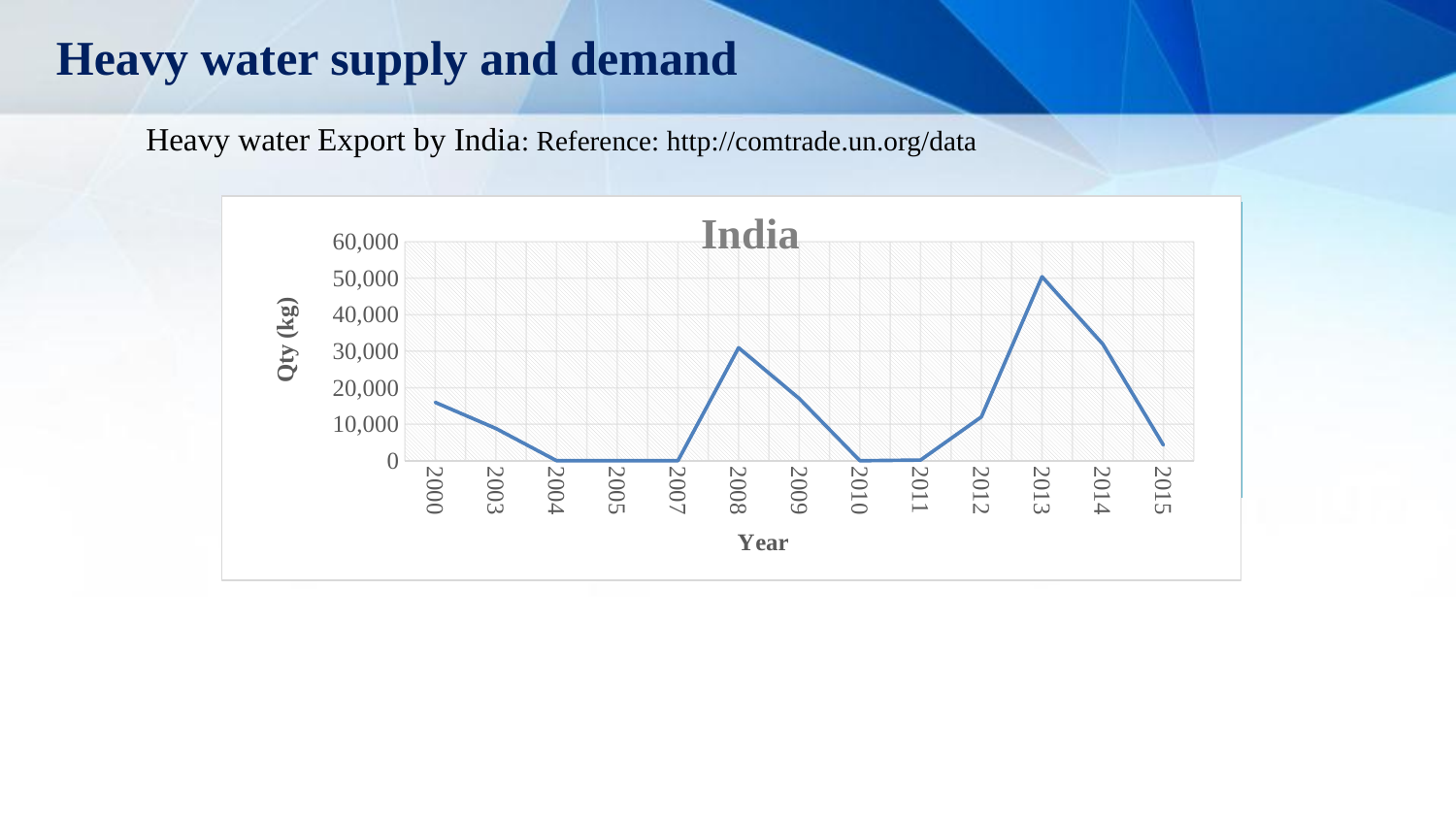
Is the value for 2015 greater or less than 10,000? less Do the values rise or fall from 2013 to 2015? fall How many years are plotted on the x axis of the chart? 13 What kind of chart is shown on the slide? line chart What is the title of the chart? India Which is larger, the value for 2012 or the value for 2014? 2014 Is the value for 2013 greater or less than 40,000? greater What is the label of the vertical axis of the chart? Qty (kg) Is the value for 2000 greater or less than 20,000? less Which year has the highest heavy water export quantity in the chart? 2013 Which is larger, the value for 2008 or the value for 2009? 2008